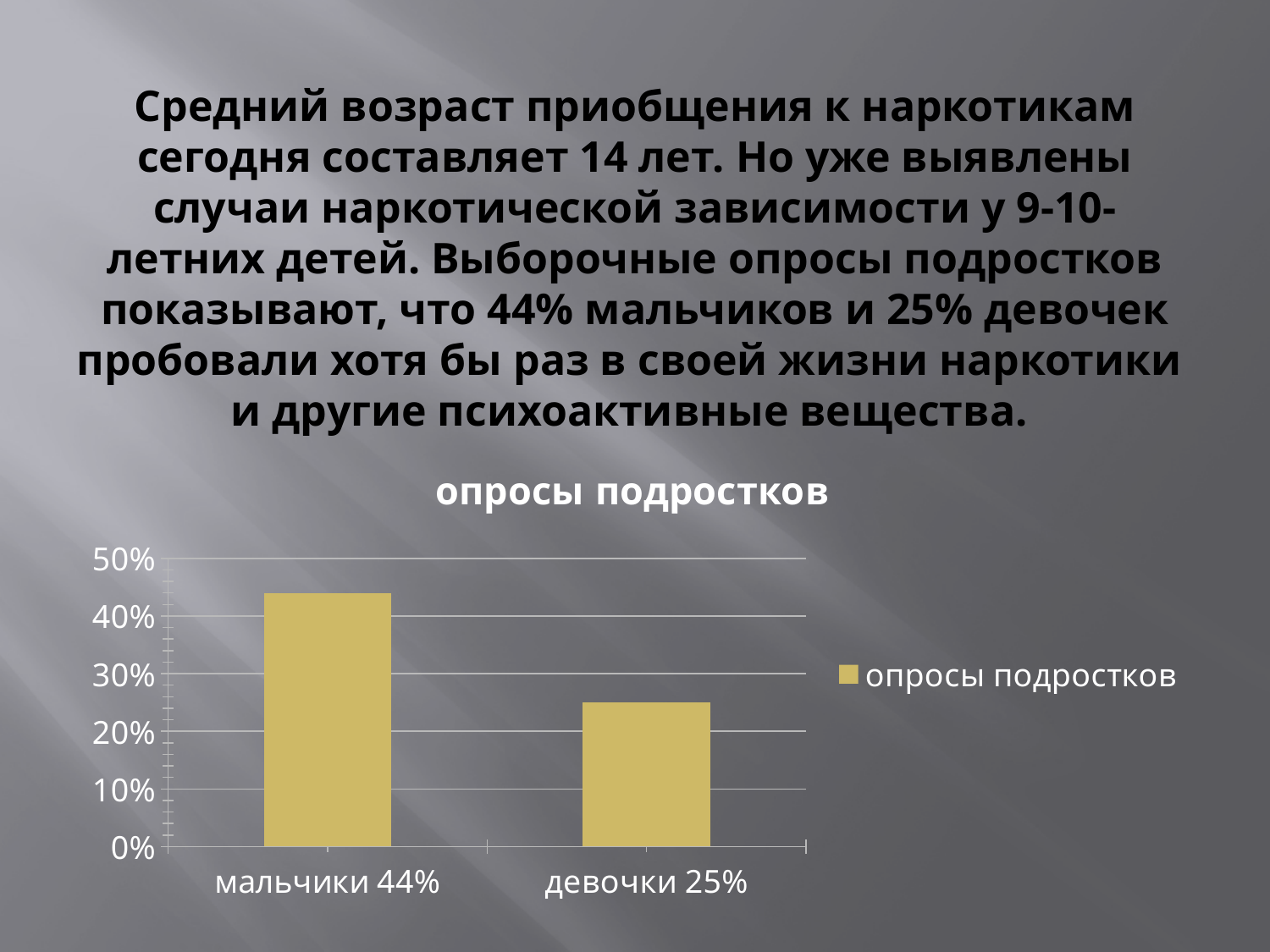
What is the name of the series shown in the legend? опросы подростков Which category has the highest value? мальчики What kind of chart is shown on the slide? bar chart What is the value for девочки? 25% Which category has the lowest value? девочки How many series does the legend list? 1 How many bars does the chart have? 2 What is the value for мальчики? 44% Which is larger, the value for мальчики or the value for девочки? мальчики What is the title of the chart? опросы подростков What is the difference between the values for мальчики and девочки? 19% Is the value for девочки greater or less than 30%? less